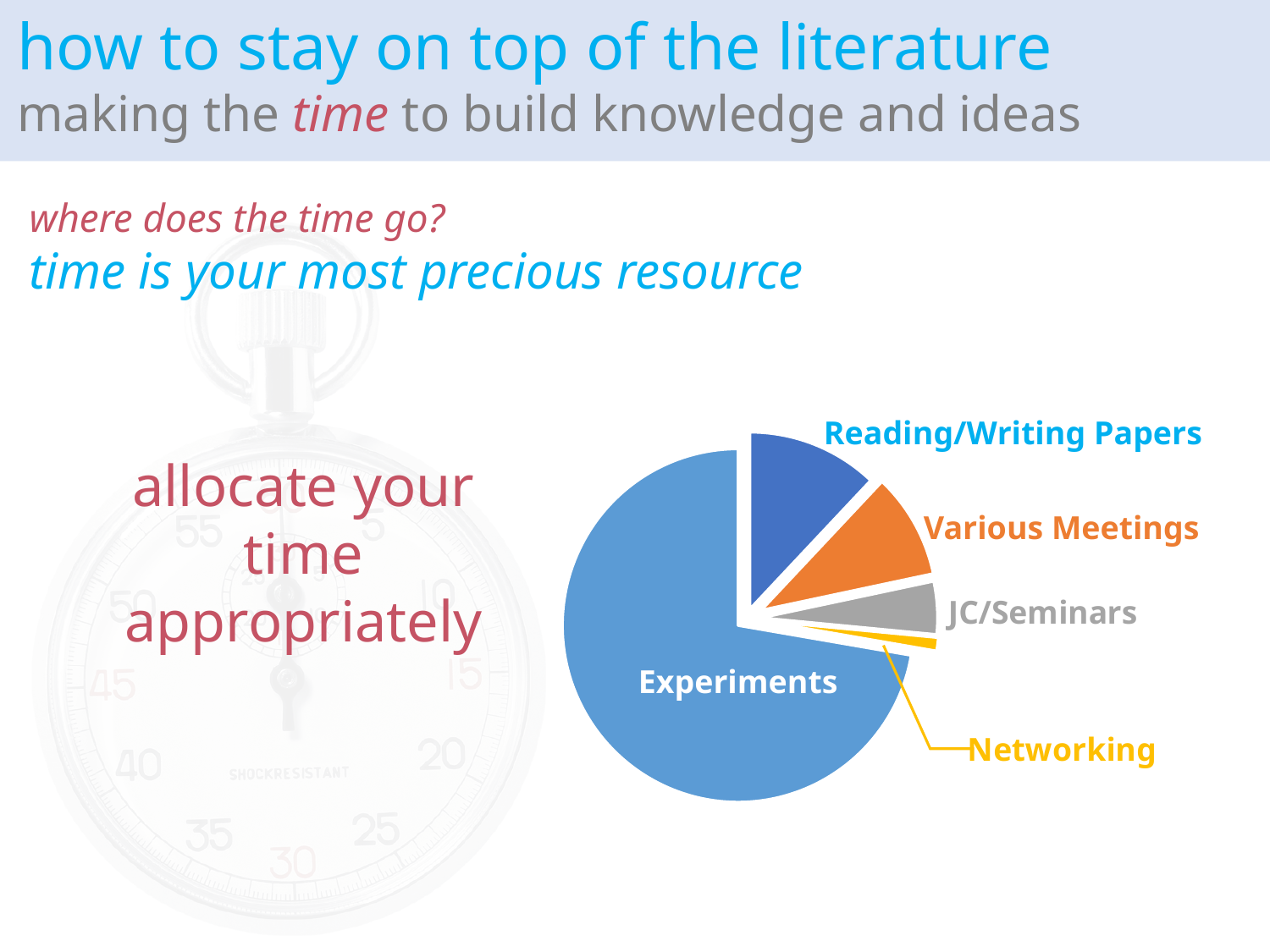
What colour is the Various Meetings slice in the pie chart? orange Which slice is larger, Various Meetings or JC/Seminars? Various Meetings Which slice is larger, Experiments or Various Meetings? Experiments Which category's label is connected to its slice by a leader line? Networking Which slice is larger, Reading/Writing Papers or Various Meetings? Reading/Writing Papers How many slices does the pie chart have? 5 What kind of chart is shown on the slide? pie chart Which category takes up the smallest share of the pie chart? Networking Which category takes up the largest share of the pie chart? Experiments